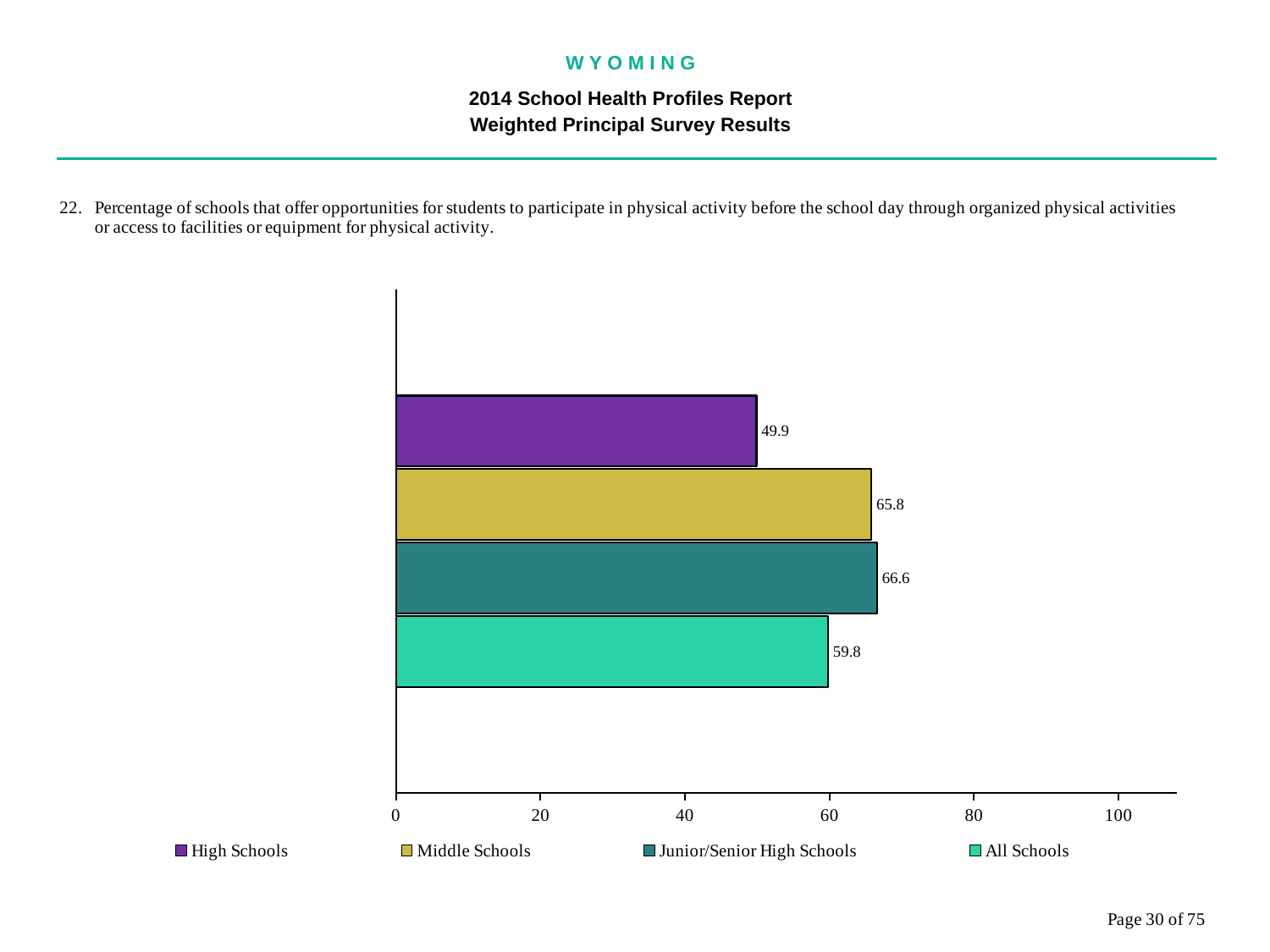
What is the value for High Schools? 49.9 What kind of chart is shown on the slide? bar chart Which school type has the highest value? Junior/Senior High Schools Which school type has the lowest value? High Schools What is the difference between the values for Junior/Senior High Schools and All Schools? 6.8 How many series does the legend list? 4 What is the value for Middle Schools? 65.8 What is the value for Junior/Senior High Schools? 66.6 Is the value for High Schools greater or less than 60? less What is the value for All Schools? 59.8 Which is larger, the value for All Schools or the value for High Schools? All Schools What is the difference between the values for Middle Schools and High Schools? 15.9